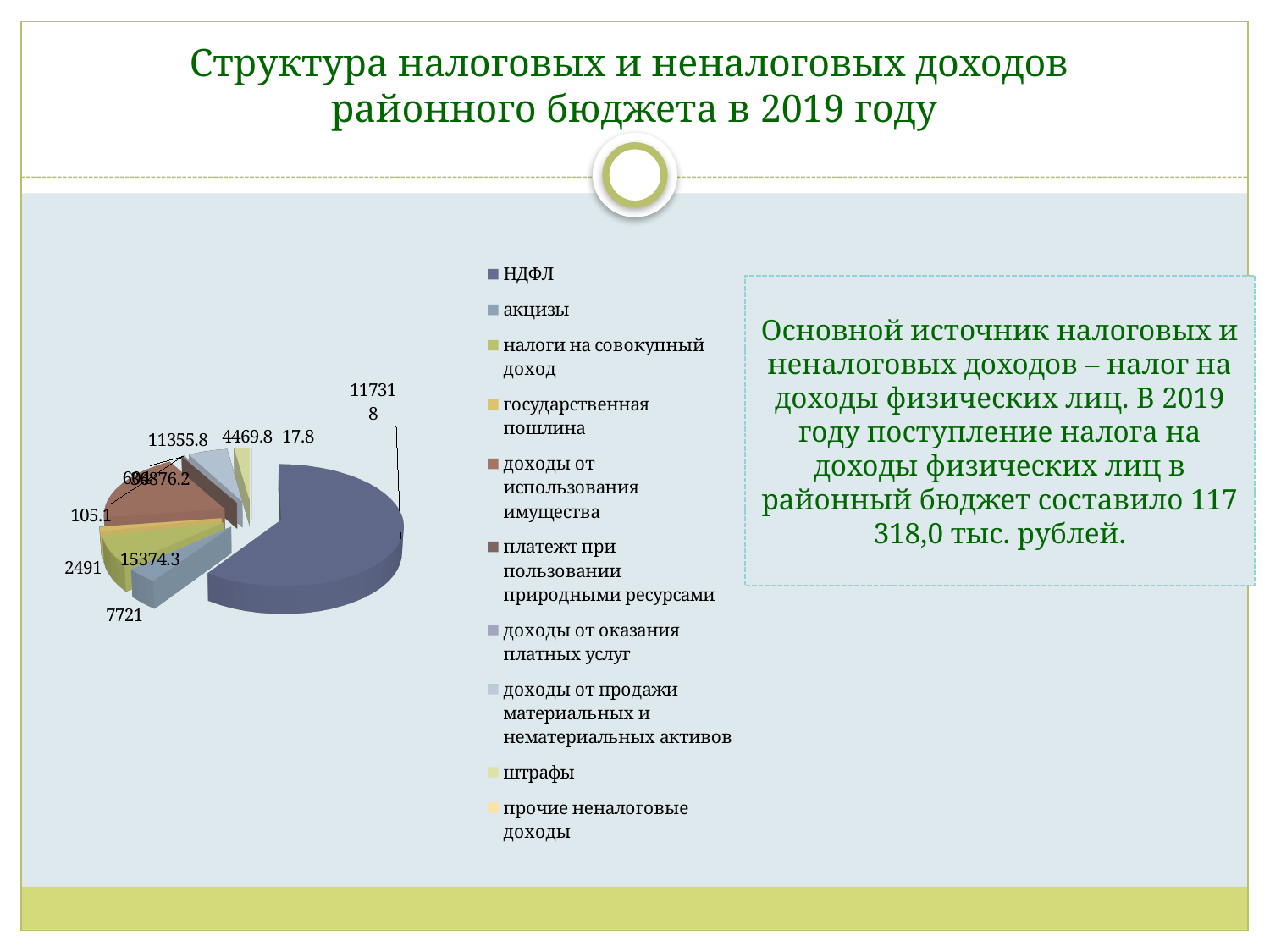
What kind of chart is shown on the slide? pie chart What is the smallest data label value printed on the pie chart? 17.8 How many categories does the legend of the pie chart list? 10 What is the title of the slide containing the pie chart? Структура налоговых и неналоговых доходов районного бюджета в 2019 году What is the value shown for акцизы in the pie chart? 7721 Is the value for НДФЛ greater or less than 100000? greater Which category is listed first in the pie chart's legend? НДФЛ Which is larger in the pie chart, НДФЛ or акцизы? НДФЛ What is the value shown for НДФЛ in the pie chart? 117318 Which category has the largest slice of the pie chart? НДФЛ